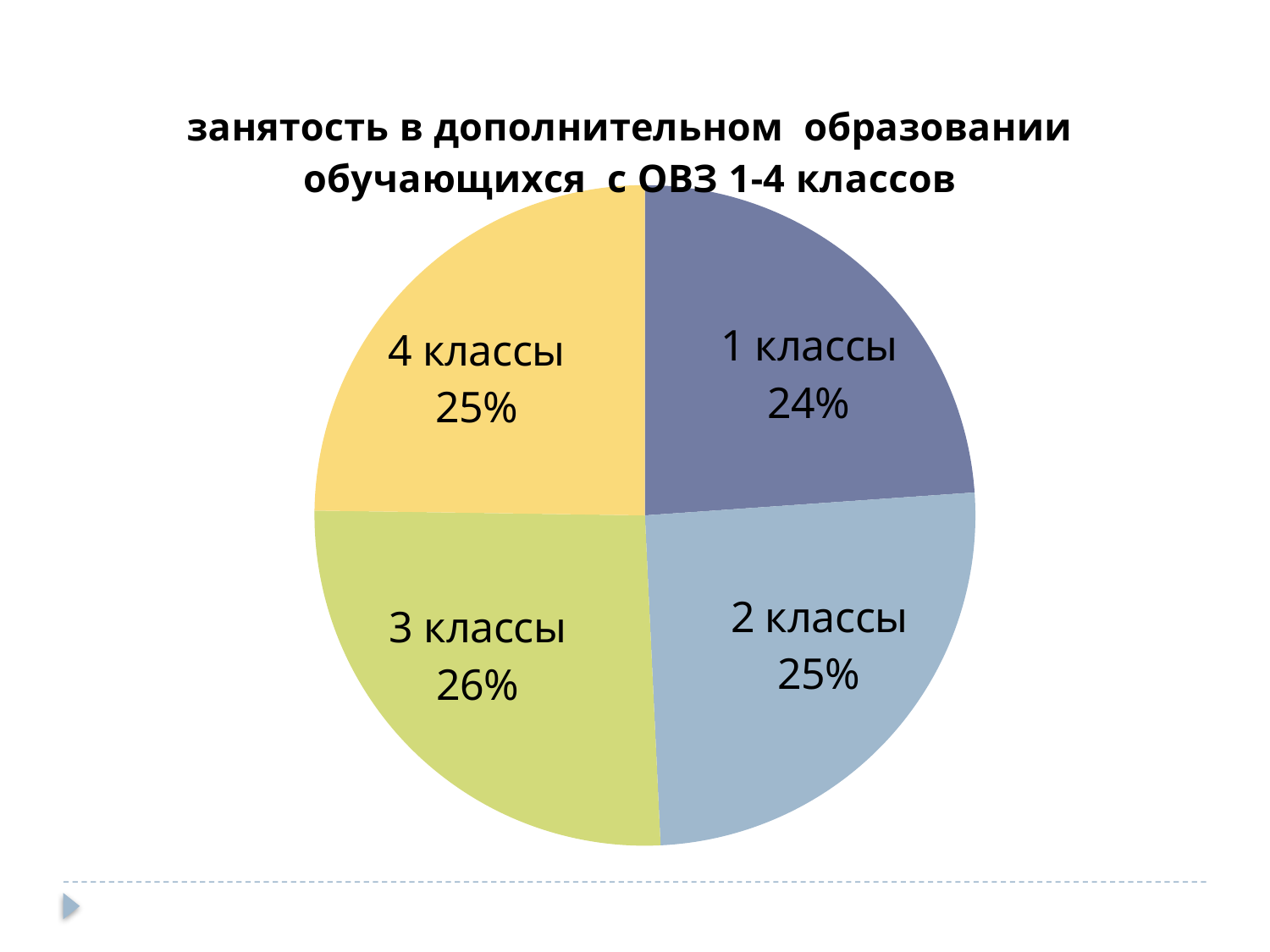
What share of the pie does the slice for 4 классы represent? 25% What share of the pie does the slice for 3 классы represent? 26% How many slices does the pie chart have? 4 What share of the pie does the slice for 1 классы represent? 24% What colour is the slice for 4 классы? Yellow Which category has the smallest slice of the pie? 1 классы What is the difference in percentage points between the slices for 3 классы and 1 классы? 2 percentage points What is the title of the chart? занятость в дополнительном образовании обучающихся с ОВЗ 1-4 классов What kind of chart is shown on the slide? Pie chart Which category has the largest slice of the pie? 3 классы Which slice is larger, 3 классы or 1 классы? 3 классы